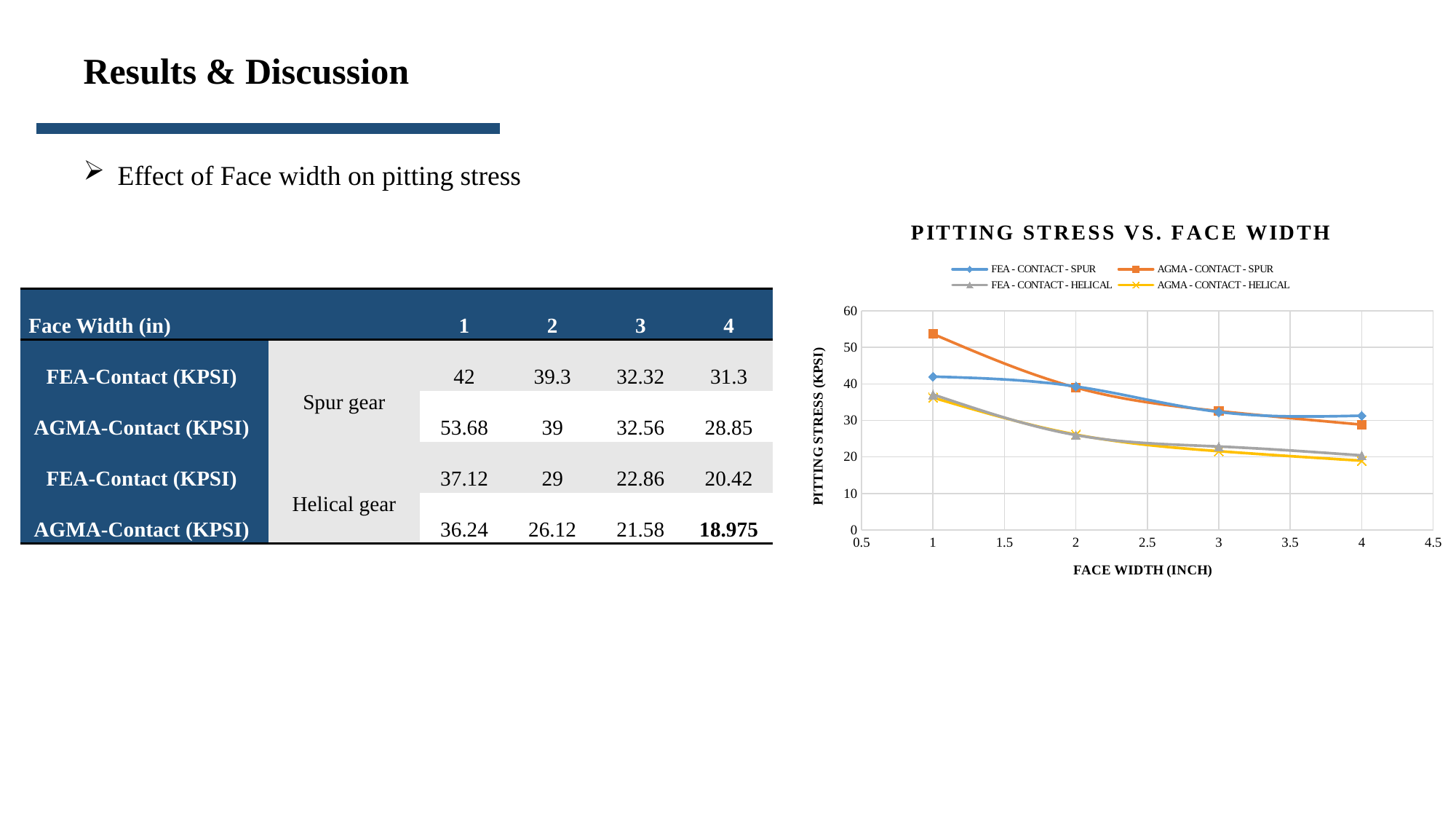
At a face width of 2 inches, which is larger: the pitting stress for FEA - CONTACT - SPUR or for FEA - CONTACT - HELICAL? FEA - CONTACT - SPUR What kind of chart is shown on the slide? line chart What is the title of the x axis of the chart? FACE WIDTH (INCH) What is the pitting stress for FEA - CONTACT - SPUR at a face width of 1 inch? 42 Do the pitting stress values rise or fall as face width increases along the x axis? fall How many series does the legend of the 'PITTING STRESS VS. FACE WIDTH' chart list? 4 How many face width values are plotted for each series in the chart? 4 Is the pitting stress for FEA - CONTACT - HELICAL at a face width of 4 inches greater or less than 30? less Is the pitting stress for AGMA - CONTACT - SPUR at a face width of 1 inch greater or less than 50? greater Which series has the lowest pitting stress at a face width of 4 inches? AGMA - CONTACT - HELICAL What is the difference between the AGMA - CONTACT - SPUR and FEA - CONTACT - SPUR pitting stress values at a face width of 1 inch? 11.68 Which series has the highest pitting stress at a face width of 1 inch? AGMA - CONTACT - SPUR